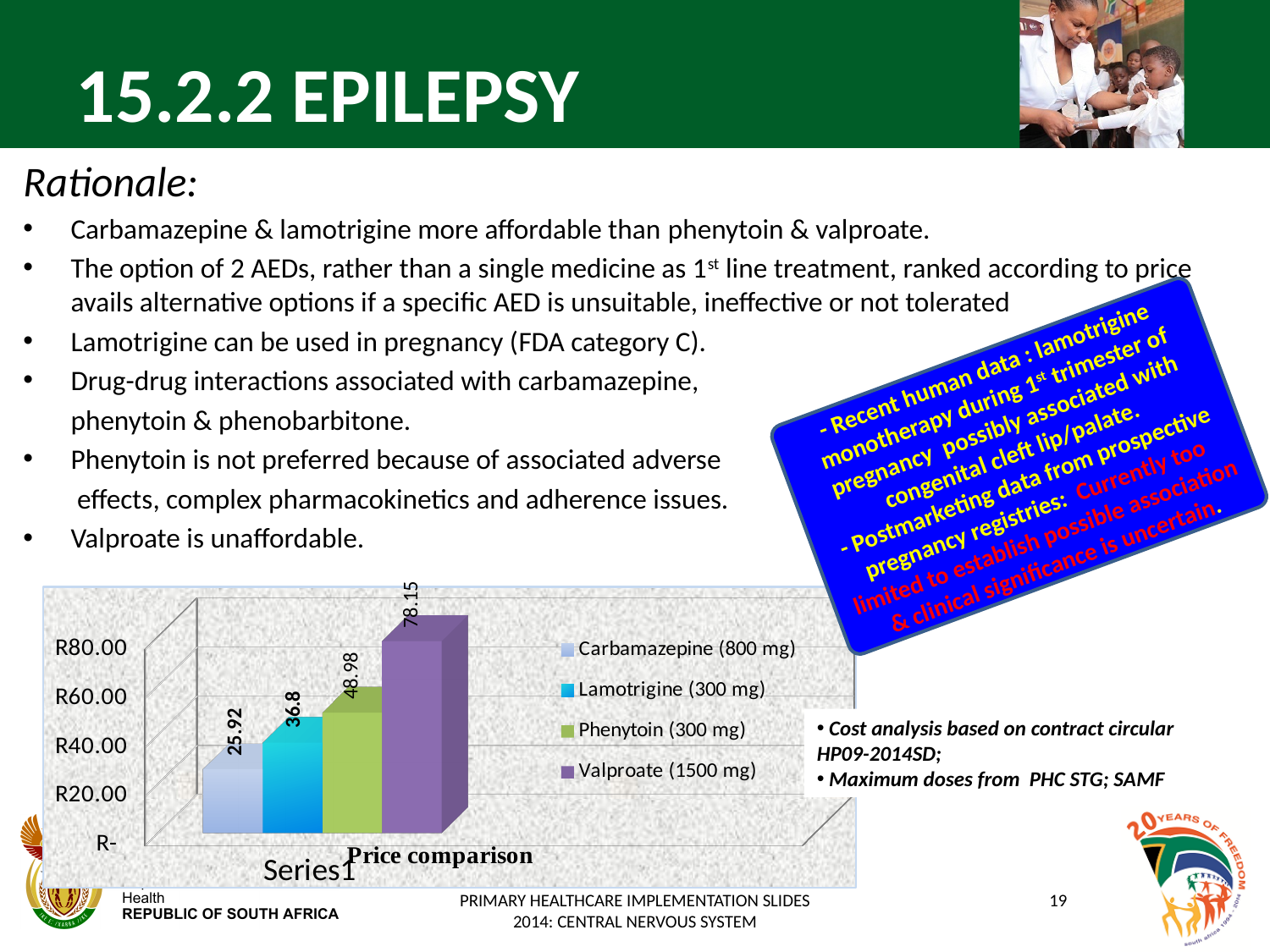
Which has the larger value in the Price comparison chart, Lamotrigine (300 mg) or Phenytoin (300 mg)? Phenytoin (300 mg) What kind of chart is the Price comparison chart? Bar chart Is the value for Phenytoin (300 mg) in the Price comparison chart greater or less than R40.00? greater What is the value shown for Lamotrigine (300 mg) in the Price comparison chart? 36.8 What is the value shown for Phenytoin (300 mg) in the Price comparison chart? 48.98 Which medicine has the highest value in the Price comparison chart? Valproate (1500 mg) How many series does the legend of the Price comparison chart list? 4 Which medicine has the lowest value in the Price comparison chart? Carbamazepine (800 mg) What is the difference between the values for Valproate (1500 mg) and Carbamazepine (800 mg) in the Price comparison chart? 52.23 What is the value shown for Valproate (1500 mg) in the Price comparison chart? 78.15 What is the title of the chart on the slide? Price comparison What is the value shown for Carbamazepine (800 mg) in the Price comparison chart? 25.92